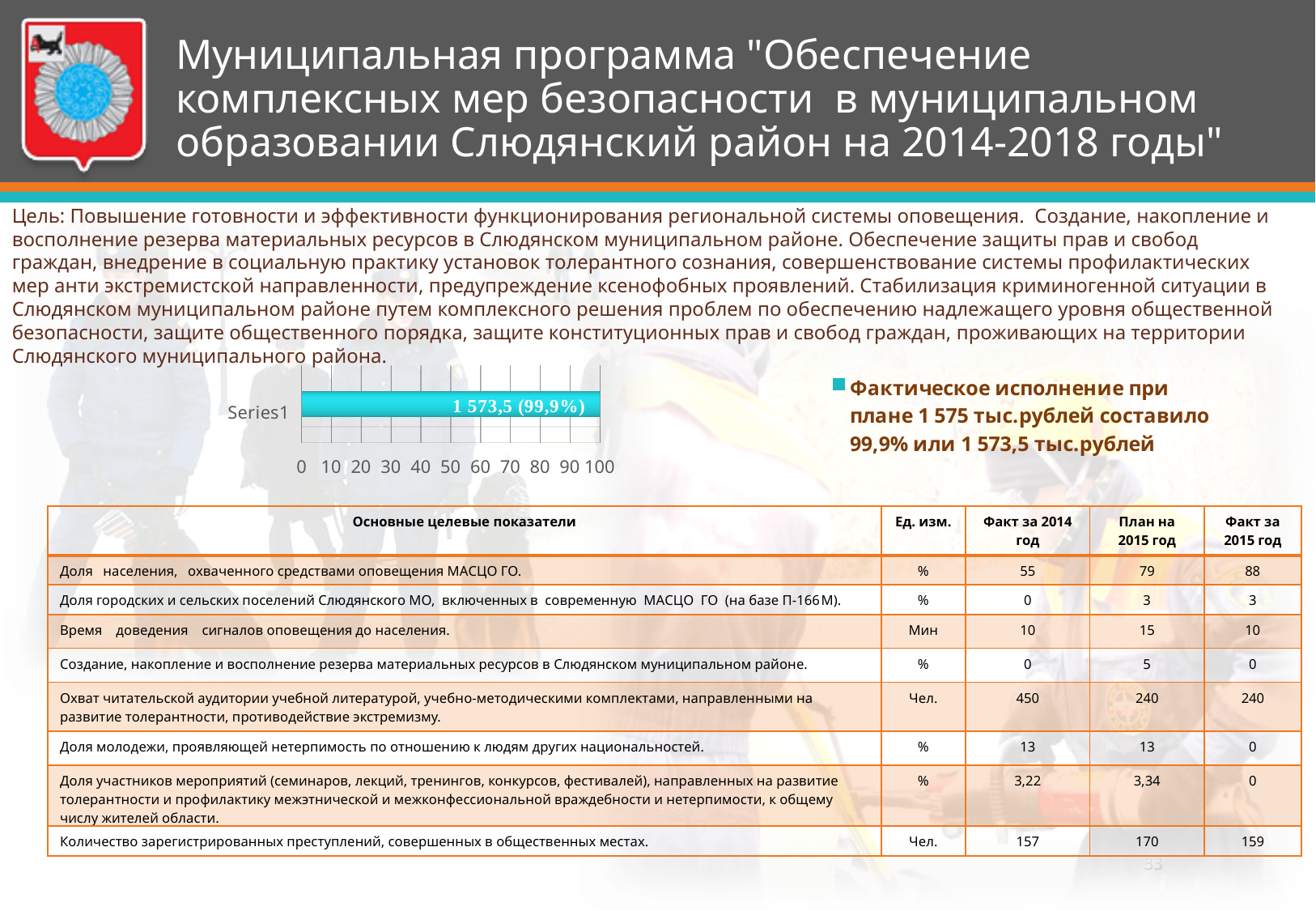
What is the category label shown on the vertical axis of the chart? Series1 Is the value of the bar for Series1 greater or less than 50 on the horizontal axis? greater Is the value of the bar for Series1 greater or less than 90 on the horizontal axis? greater What kind of chart is shown on the slide? bar chart How many bars does the chart contain? 1 What percentage is shown in parentheses in the bar's data label? 99,9% What is the highest tick value shown on the horizontal axis of the chart? 100 What data label is printed on the bar in the chart? 1 573,5 (99,9%)